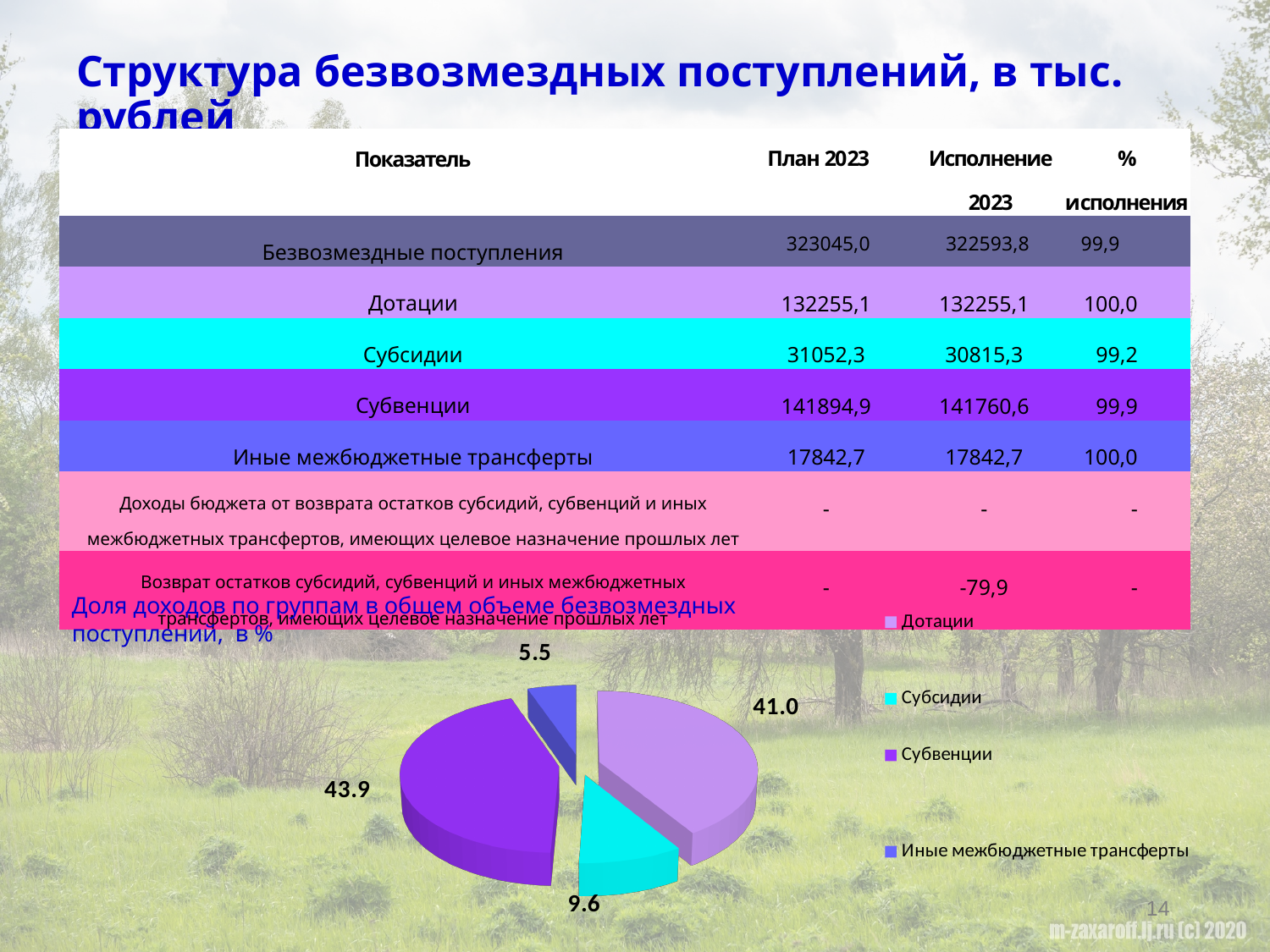
What colour is the Субсидии slice in the pie chart? cyan Which category has the smallest slice in the pie chart? Иные межбюджетные трансферты What is the share for Субвенции in the pie chart? 43.9 How many entries does the pie chart legend list? 4 What is the share for Дотации in the pie chart? 41.0 How many slices does the pie chart have? 4 What kind of chart is shown on the slide? pie chart What is the share for Субсидии in the pie chart? 9.6 Which category has the largest slice in the pie chart? Субвенции What is the difference between the shares of Субвенции and Дотации in the pie chart? 2.9 Which is larger in the pie chart, the share for Субсидии or the share for Иные межбюджетные трансферты? Субсидии What is the share for Иные межбюджетные трансферты in the pie chart? 5.5